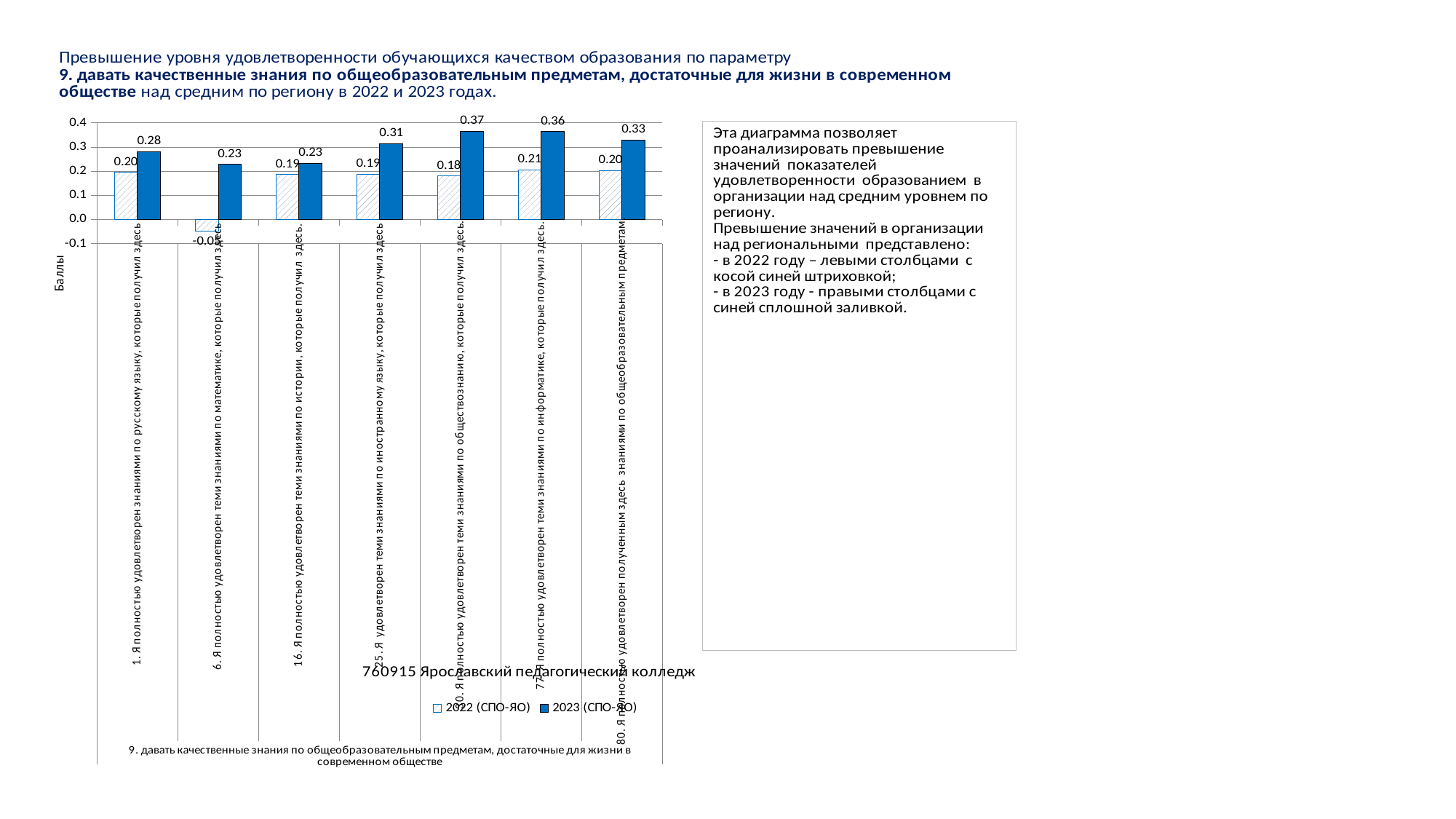
Is the 2022 (СПО-ЯО) value for the category about математика (6) greater or less than 0.0? less How many series does the legend list? 2 Which category has the lowest 2022 (СПО-ЯО) value? 6. Я полностью удовлетворен теми знаниями по математике, которые получил здесь What is the difference between the 2023 and 2022 values for the category about информатика (77)? 0.15 What is the difference between the 2023 and 2022 values for the category about обществознание (50)? 0.19 What kind of chart is shown on the slide? bar chart How many categories are shown on the x axis of the chart? 7 What is the 2022 (СПО-ЯО) value for the category about русский язык (1)? 0.20 Which category has the highest 2023 (СПО-ЯО) value? 30. Я полностью удовлетворен теми знаниями по обществознанию, которые получил здесь. What is the 2023 (СПО-ЯО) value for the category about обществознание (50)? 0.37 What is the 2023 (СПО-ЯО) value for the category about информатика (77)? 0.36 Which is larger for the category about иностранный язык (25): the 2022 value or the 2023 value? 2023